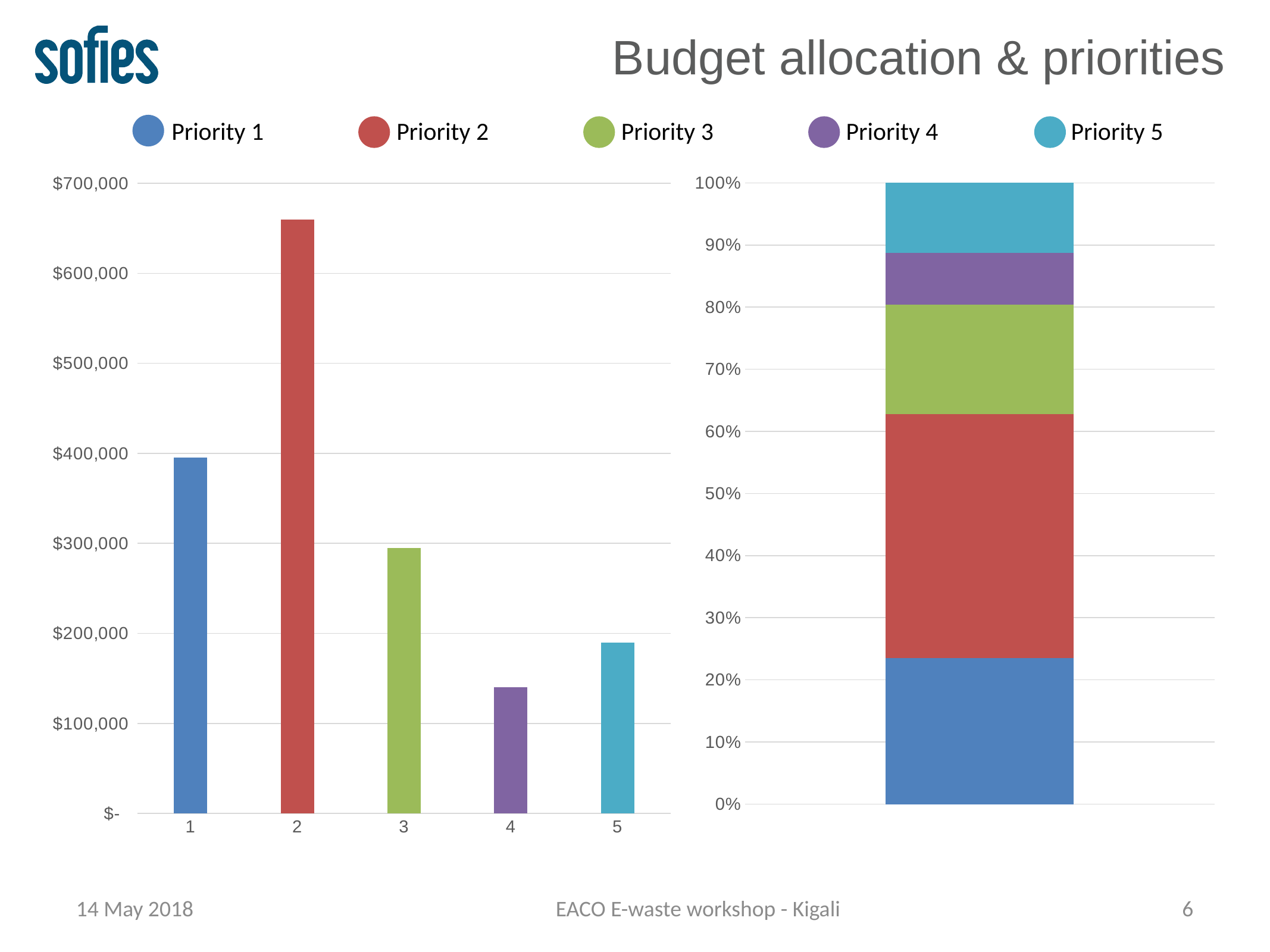
In the left-hand chart, is the value for category 4 greater or less than $200,000? less What kind of chart is the left-hand chart on the slide? bar chart How many bars are plotted in the left-hand chart? 5 How many series does the legend list? 5 In the left-hand chart, which is larger, the value for category 1 or category 3? 1 In the left-hand chart, is the value for category 2 greater or less than $600,000? greater In the left-hand chart, which category has the lowest value? 4 In the left-hand chart, is the value for category 1 greater or less than $300,000? greater What kind of chart is the right-hand chart on the slide? stacked bar chart In the right-hand stacked chart, which priority takes the largest share of the bar? Priority 2 In the left-hand chart, which category has the highest value? 2 In the left-hand chart, which is larger, the value for category 4 or category 5? 5